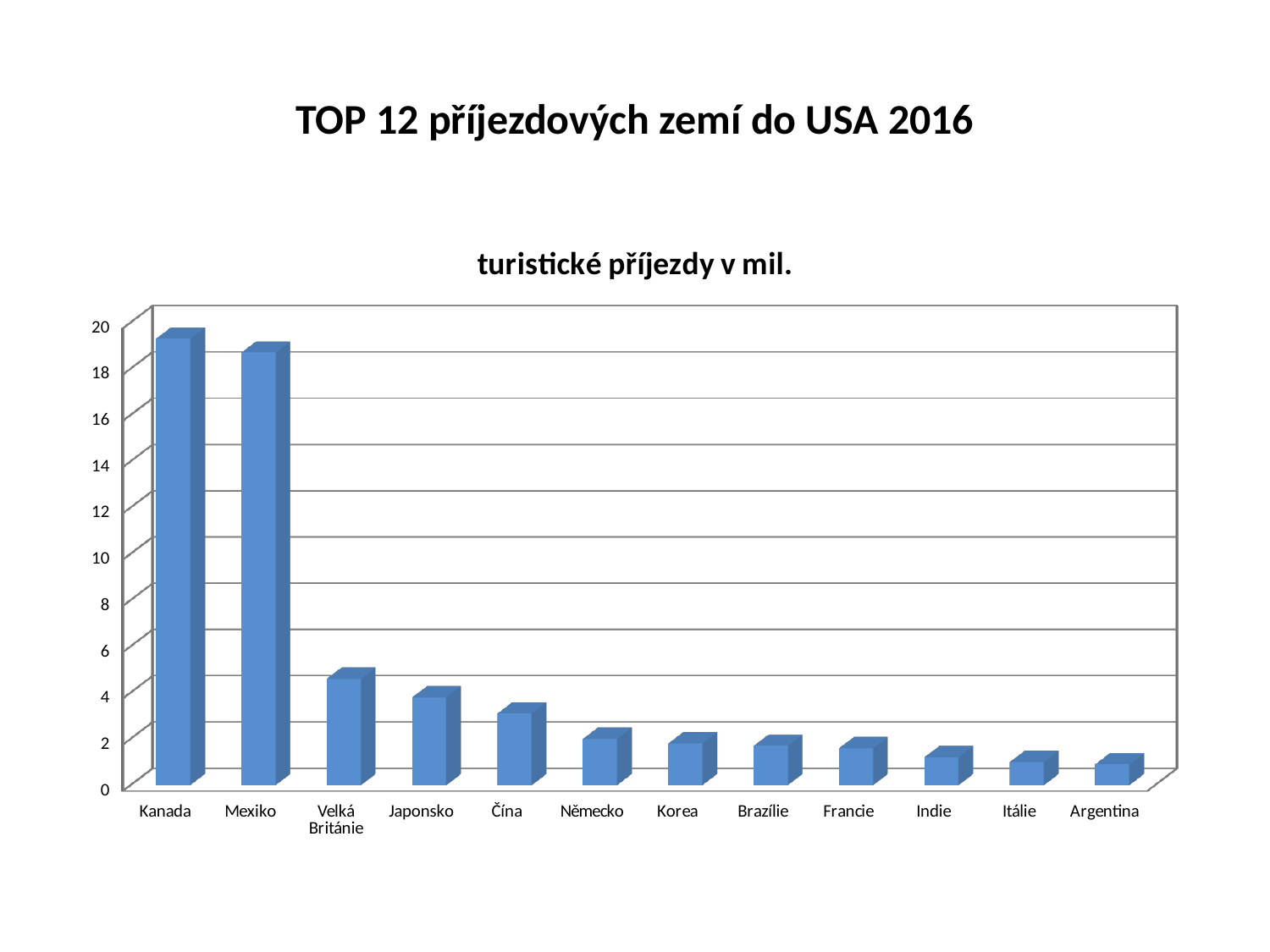
Is the value for Mexiko greater or less than 16? greater Which has a larger value, Čína or Německo? Čína What type of chart is shown on the slide? bar chart How many countries are shown on the x axis of the chart? 12 Do the values rise or fall moving from left to right along the x axis? fall What is the title of the chart? turistické příjezdy v mil. Which country has the highest value in the chart? Kanada Is the value for Indie greater or less than 2? less Is the value for Velká Británie greater or less than 4? greater Which has a larger value, Velká Británie or Japonsko? Velká Británie